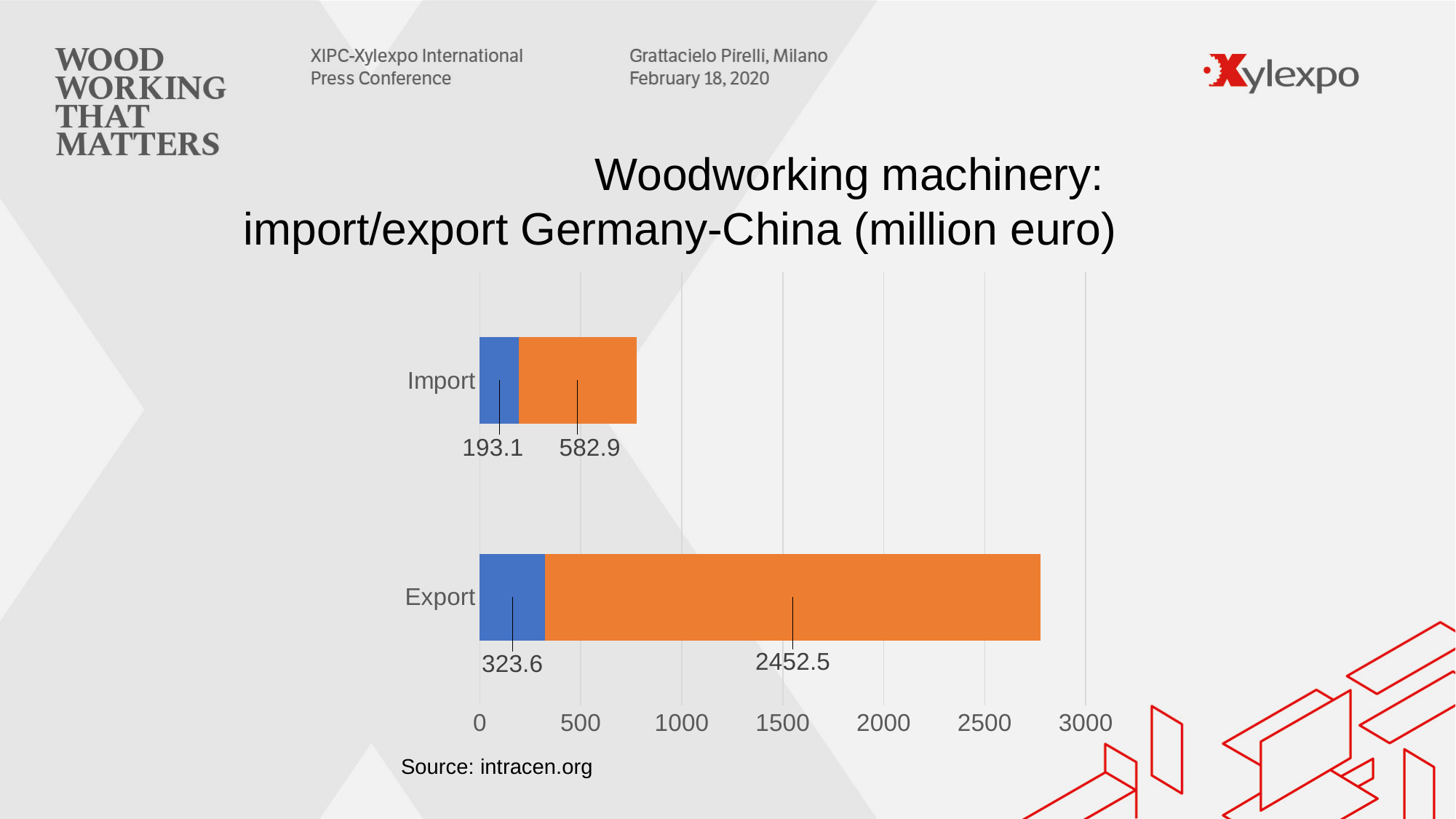
What kind of chart is shown on the slide? bar chart What is the value of the blue segment of the Export bar? 323.6 What is the total of the Export stacked bar? 2776.1 What is the total of the Import stacked bar? 776 What is the value of the orange segment of the Import bar? 582.9 What is the value of the orange segment of the Export bar? 2452.5 Which category has the longer bar overall, Import or Export? Export What is the source cited below the chart? intracen.org What is the difference between the orange segment of Export and the orange segment of Import? 1869.6 What is the value of the blue segment of the Import bar? 193.1 Is the total value of the Import bar greater or less than 1000? less How many categories are plotted on the chart? 2